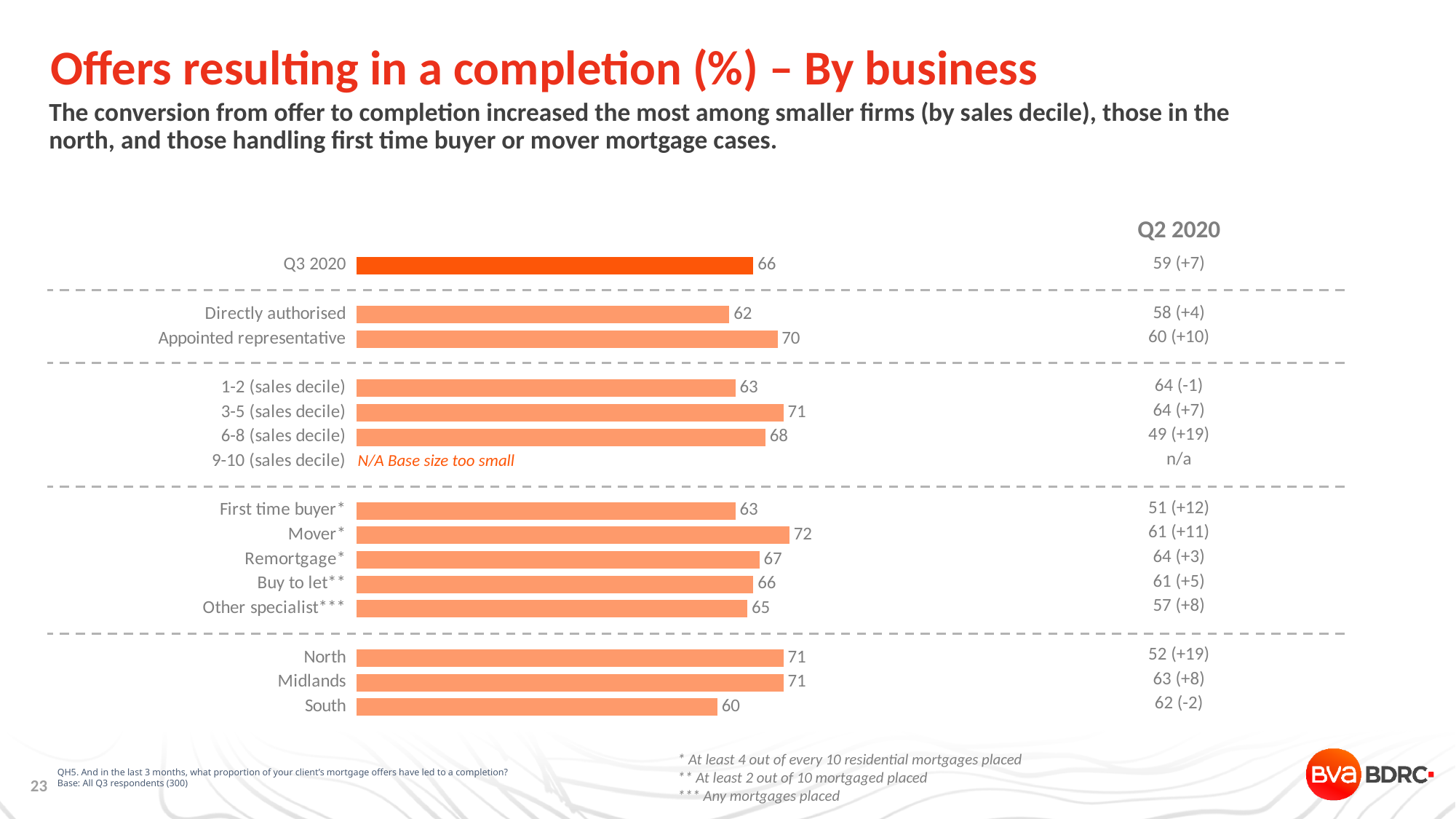
What is the value for Q3 2020 overall? 66 What is the value for Appointed representative? 70 Which is larger, the value for North or the value for South? North Which category has the lowest value in the chart? South Which category has the highest value in the chart? Mover How many bars are plotted in the chart? 14 What is the difference between the values for Mover and First time buyer? 9 What kind of chart is shown on the slide? bar chart What is the value for Other specialist? 65 What is shown for 9-10 (sales decile) instead of a bar? N/A Base size too small What is the value for 6-8 (sales decile)? 68 What is the difference between the values for Appointed representative and Directly authorised? 8